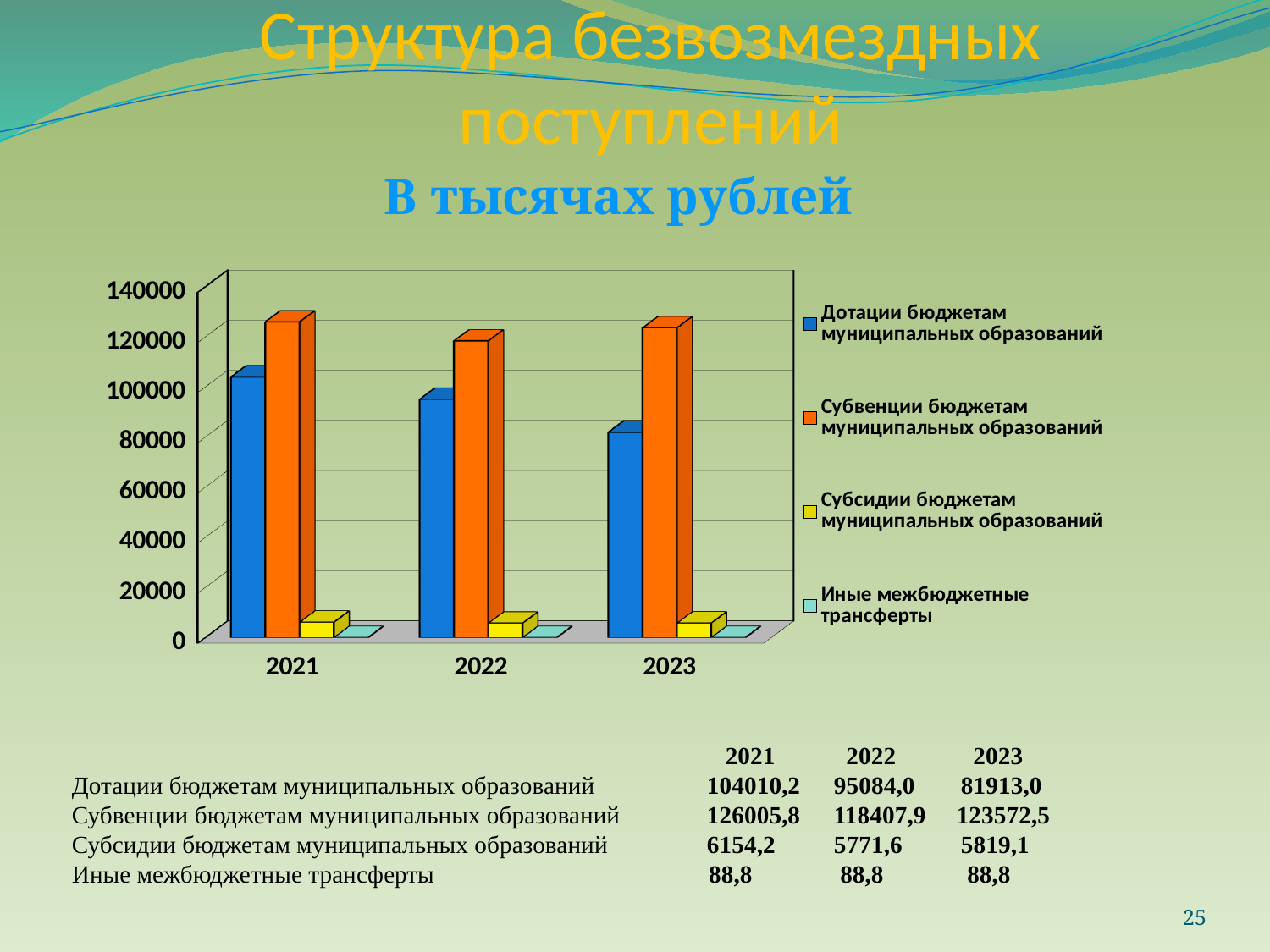
How many years are shown on the x axis of the chart? 3 What is the difference between Дотации бюджетам муниципальных образований in 2021 and in 2023? 22097,2 What is the value of Субвенции бюджетам муниципальных образований for 2023? 123572,5 What kind of chart is shown on the slide? bar chart In which year is Дотации бюджетам муниципальных образований the lowest? 2023 In which year is Субвенции бюджетам муниципальных образований the highest? 2021 What is the value of Дотации бюджетам муниципальных образований for 2021? 104010,2 What is the value of Иные межбюджетные трансферты for 2023? 88,8 What is the value of Субсидии бюджетам муниципальных образований for 2022? 5771,6 Which is larger in 2022: Дотации бюджетам муниципальных образований or Субвенции бюджетам муниципальных образований? Субвенции бюджетам муниципальных образований Do the values for Дотации бюджетам муниципальных образований rise or fall from 2021 to 2023? fall How many series does the chart legend list? 4